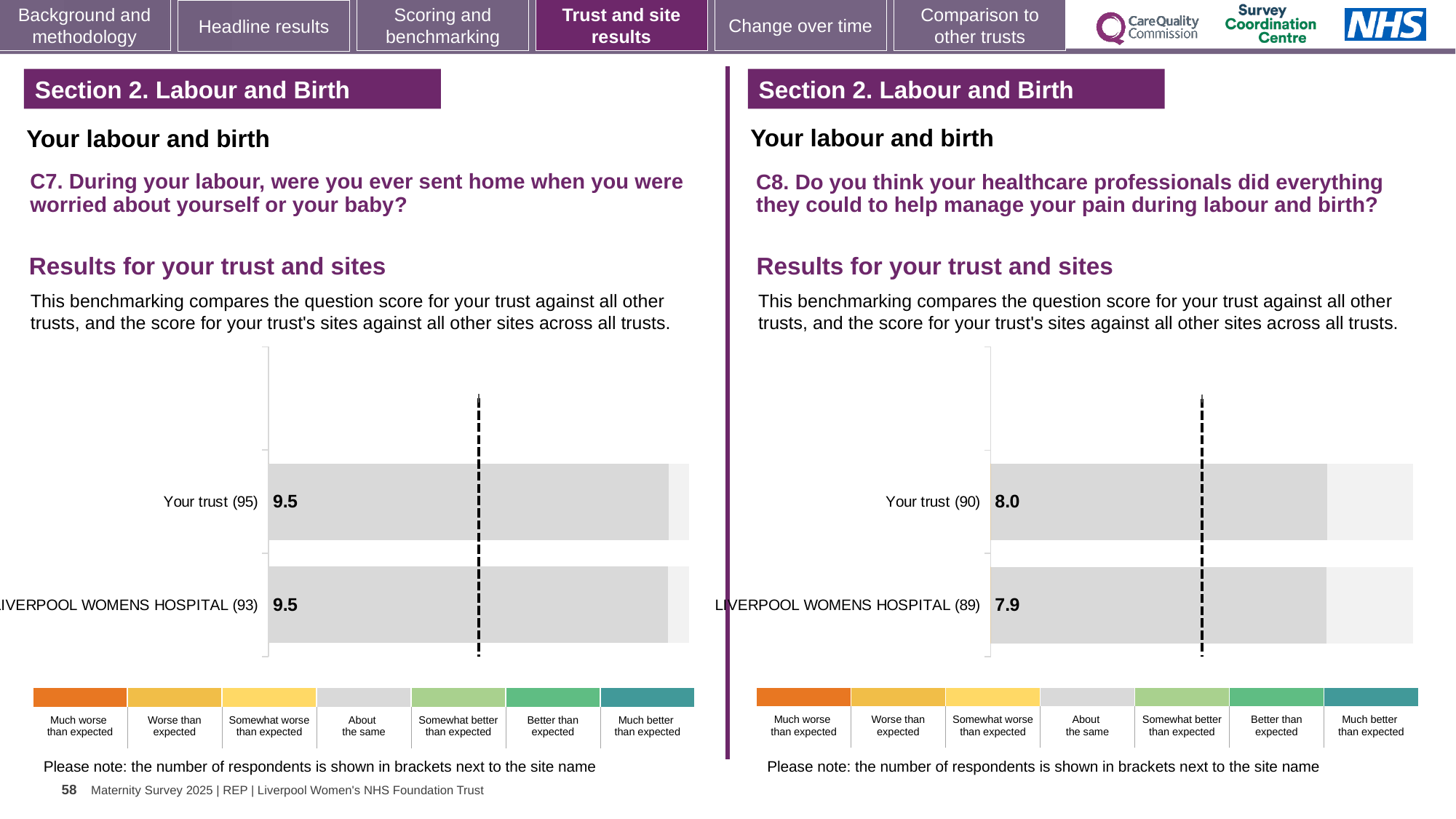
In the C7 chart on the left, how many respondents are shown in brackets for Your trust? 95 In the C8 chart on the right, what is the score for LIVERPOOL WOMENS HOSPITAL? 7.9 In the C7 chart on the left, what is the score for LIVERPOOL WOMENS HOSPITAL? 9.5 In the C8 chart on the right, what is the difference between the score for Your trust and the score for LIVERPOOL WOMENS HOSPITAL? 0.1 How many bars are plotted in the C7 chart on the left? 2 In the C8 chart on the right, what is the score for Your trust? 8.0 How many bars are plotted in the C8 chart on the right? 2 In the C8 chart on the right, which category has the lowest score? LIVERPOOL WOMENS HOSPITAL What type of chart is used for the C7 results on the left? Bar chart In the C8 chart on the right, which has the higher score, Your trust or LIVERPOOL WOMENS HOSPITAL? Your trust In the C7 chart on the left, what is the score for Your trust? 9.5 In the C8 chart on the right, how many respondents are shown in brackets for LIVERPOOL WOMENS HOSPITAL? 89